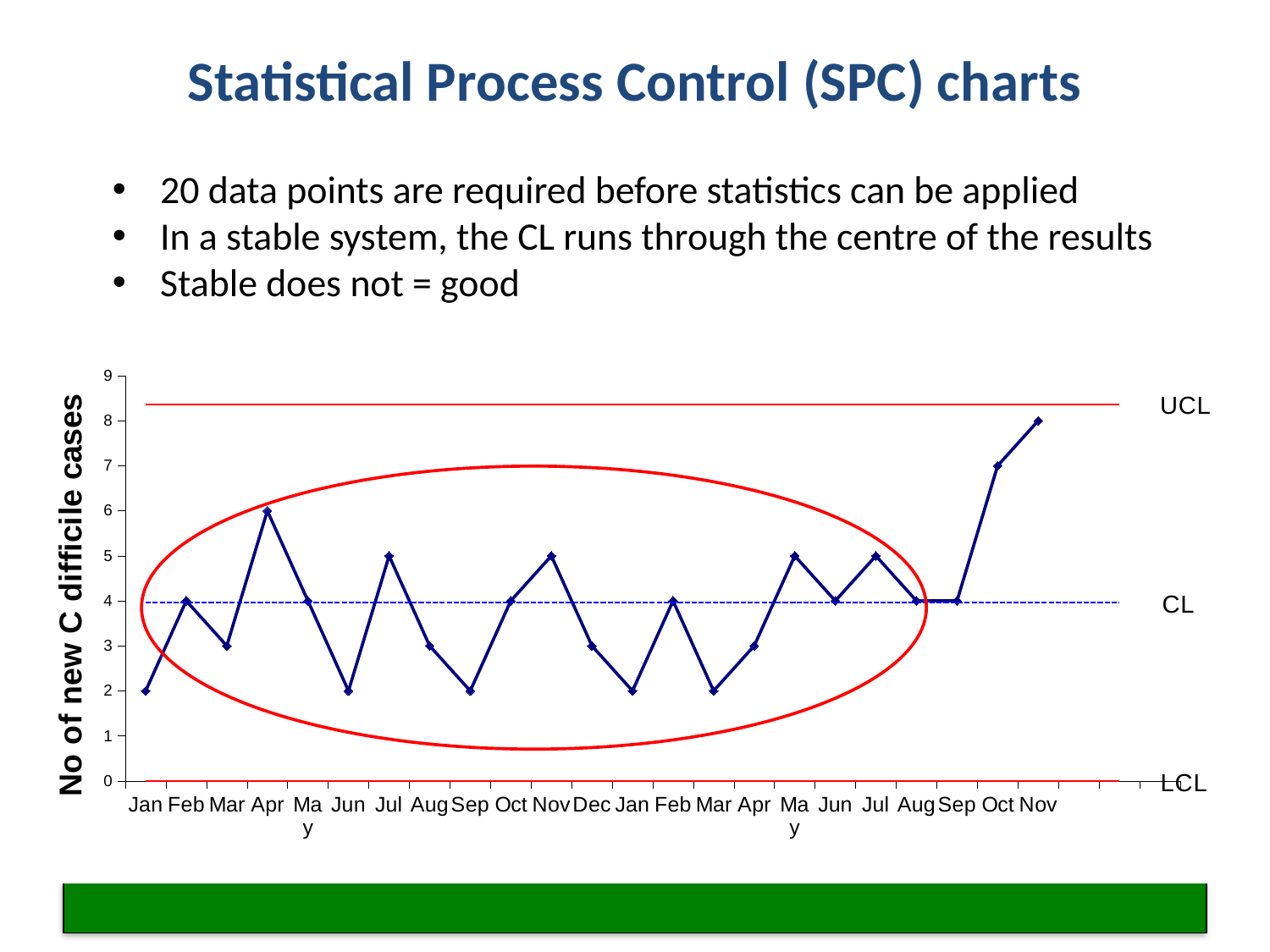
What is the difference between the value for the last Nov and the value for the first Apr? 2 What is the value for the last Oct on the chart? 7 What is the value for the first Jan on the chart? 2 What label is given to the dashed blue horizontal line on the chart? CL What is the value for the last Nov on the chart? 8 Which month has the highest value on the chart? the last Nov What is the value for the first Apr on the chart? 6 What is the y-axis title of the chart? No of new C difficile cases How many data points are plotted on the chart? 23 What kind of chart is shown on the slide? line chart Is the value for the last Oct greater or less than 5? greater Which is larger, the value for the first Jul or the value for the first Aug? the first Jul